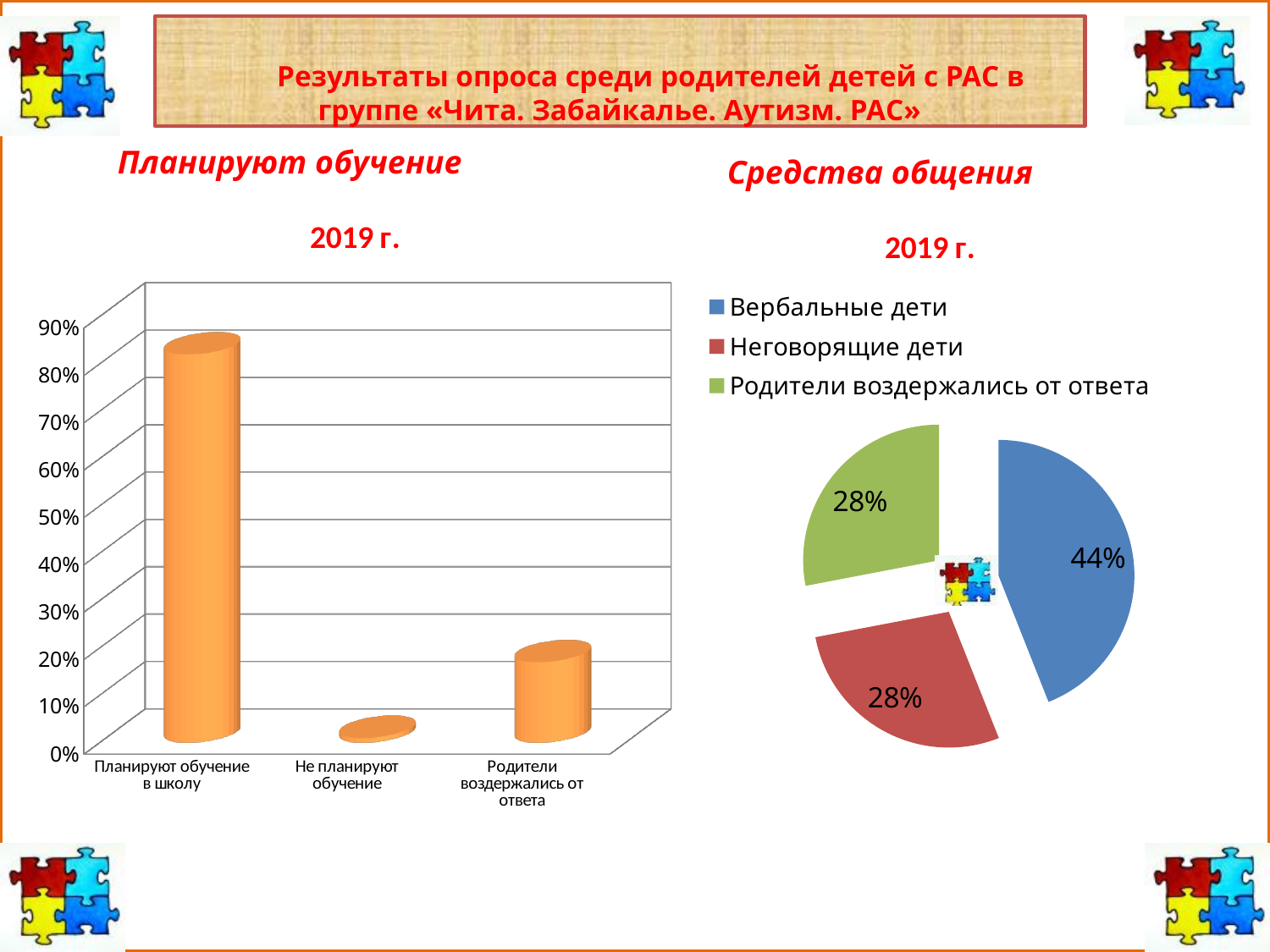
In the right pie chart "Средства общения", how many entries does the legend list? 3 What kind of chart is the right chart titled "Средства общения 2019 г."? pie chart In the left bar chart "Планируют обучение", which is larger: "Родители воздержались от ответа" or "Не планируют обучение"? Родители воздержались от ответа In the left bar chart "Планируют обучение", is the value for "Планируют обучение в школу" greater or less than 80%? greater What kind of chart is the left chart titled "Планируют обучение 2019 г."? bar chart In the right pie chart "Средства общения", which category has the largest slice? Вербальные дети In the left bar chart "Планируют обучение", which category has the lowest value? Не планируют обучение In the right pie chart "Средства общения", what share is shown for "Вербальные дети"? 44% In the right pie chart "Средства общения", what share is shown for "Неговорящие дети"? 28% In the left bar chart "Планируют обучение", is the value for "Родители воздержались от ответа" greater or less than 30%? less In the left bar chart "Планируют обучение", how many categories are shown? 3 In the left bar chart "Планируют обучение", which category has the highest value? Планируют обучение в школу